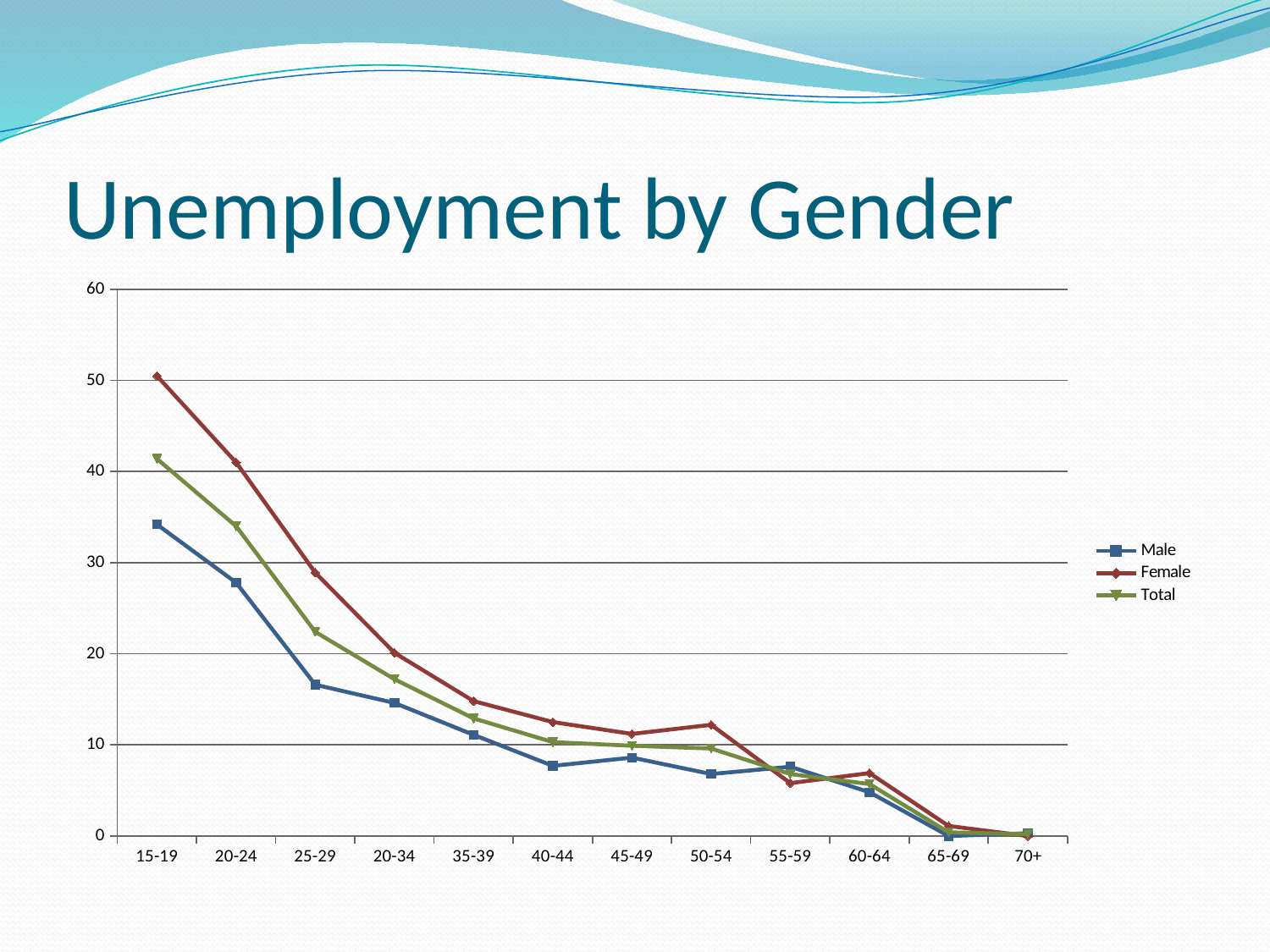
Which age group has the highest Female value? 15-19 How many age groups are shown on the x axis? 12 Which age group has the highest Male value? 15-19 Is the Total value for 20-24 greater or less than 30? greater Do the values generally rise or fall as age increases along the x axis? fall What kind of chart is shown on the slide? line chart Is the Male value for 25-29 greater or less than 20? less Is the Female value for 50-54 greater or less than 10? greater What is the title of the chart? Unemployment by Gender For the 15-19 age group, which is larger, the Male value or the Female value? Female How many series does the legend list? 3